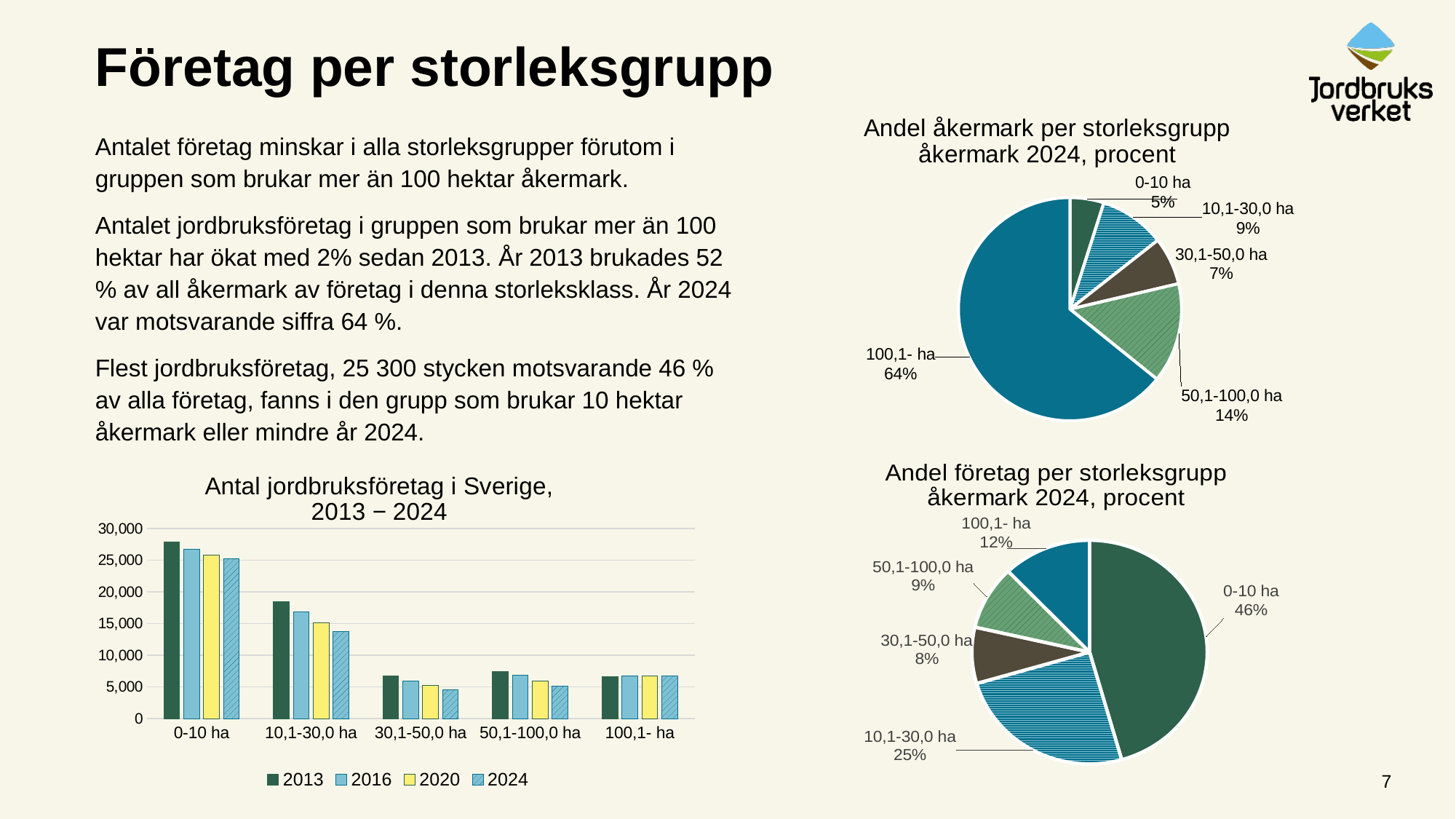
In the chart 'Antal jordbruksföretag i Sverige, 2013 − 2024', does the number of companies in the 10,1-30,0 ha group rise or fall from 2013 to 2024? Fall In the chart 'Antal jordbruksföretag i Sverige, 2013 − 2024', which size group has the highest value in 2024? 0-10 ha What kind of chart is 'Antal jordbruksföretag i Sverige, 2013 − 2024'? Bar chart In the chart 'Antal jordbruksföretag i Sverige, 2013 − 2024', is the 2013 value for 0-10 ha greater or less than 25,000? greater In the chart 'Andel åkermark per storleksgrupp åkermark 2024, procent', what share does the 100,1- ha group have? 64% In the chart 'Andel företag per storleksgrupp åkermark 2024, procent', which size group has the largest share? 0-10 ha How many series does the legend of 'Antal jordbruksföretag i Sverige, 2013 − 2024' list? 4 In the chart 'Andel åkermark per storleksgrupp åkermark 2024, procent', what is the difference between the shares of 50,1-100,0 ha and 30,1-50,0 ha? 7 percentage points In the chart 'Andel företag per storleksgrupp åkermark 2024, procent', which is larger: the share for 50,1-100,0 ha or for 30,1-50,0 ha? 50,1-100,0 ha In the chart 'Andel åkermark per storleksgrupp åkermark 2024, procent', which size group has the smallest share? 0-10 ha How many slices does the chart 'Andel företag per storleksgrupp åkermark 2024, procent' have? 5 In the chart 'Andel företag per storleksgrupp åkermark 2024, procent', what share does the 10,1-30,0 ha group have? 25%